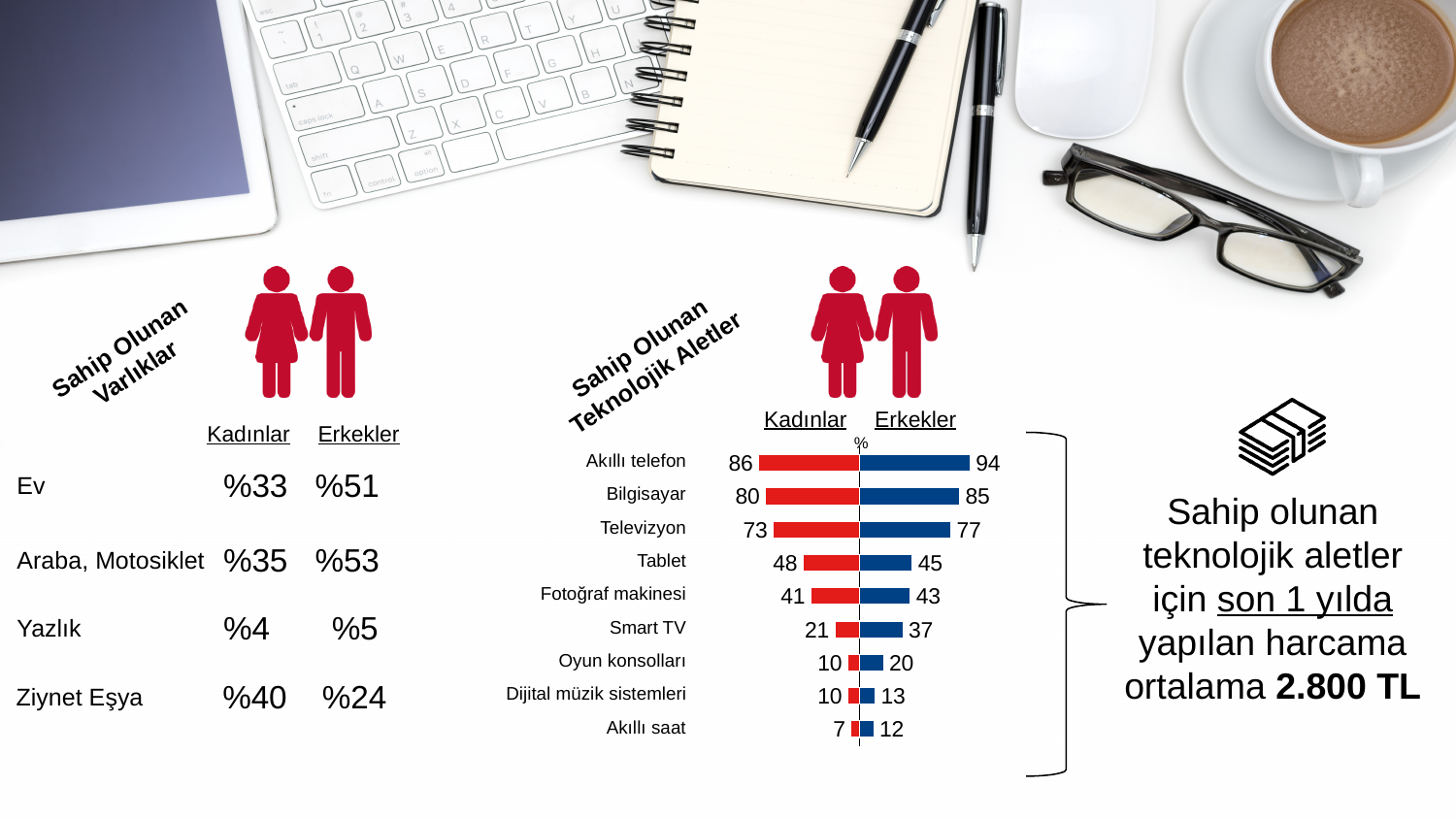
In the 'Sahip Olunan Teknolojik Aletler' chart, which category has the lowest Kadınlar value? Akıllı saat In the 'Sahip Olunan Teknolojik Aletler' chart, what is the Erkekler value for Bilgisayar? 85 In the 'Sahip Olunan Teknolojik Aletler' chart, what is the Kadınlar value for Akıllı telefon? 86 In the 'Sahip Olunan Teknolojik Aletler' chart, what is the difference between the Erkekler and Kadınlar values for Smart TV? 16 How many series does the 'Sahip Olunan Teknolojik Aletler' chart show? 2 In the 'Sahip Olunan Teknolojik Aletler' chart, which is larger for Oyun konsolları: the Kadınlar value or the Erkekler value? Erkekler In the 'Sahip Olunan Teknolojik Aletler' chart, what is the Erkekler value for Smart TV? 37 In the 'Sahip Olunan Teknolojik Aletler' chart, which is larger for Tablet: the Kadınlar value or the Erkekler value? Kadınlar In the 'Sahip Olunan Teknolojik Aletler' chart, what is the difference between the Erkekler and Kadınlar values for Akıllı telefon? 8 What type of chart is 'Sahip Olunan Teknolojik Aletler'? Bar chart How many categories are shown in the 'Sahip Olunan Teknolojik Aletler' chart? 9 In the 'Sahip Olunan Teknolojik Aletler' chart, which category has the highest Erkekler value? Akıllı telefon